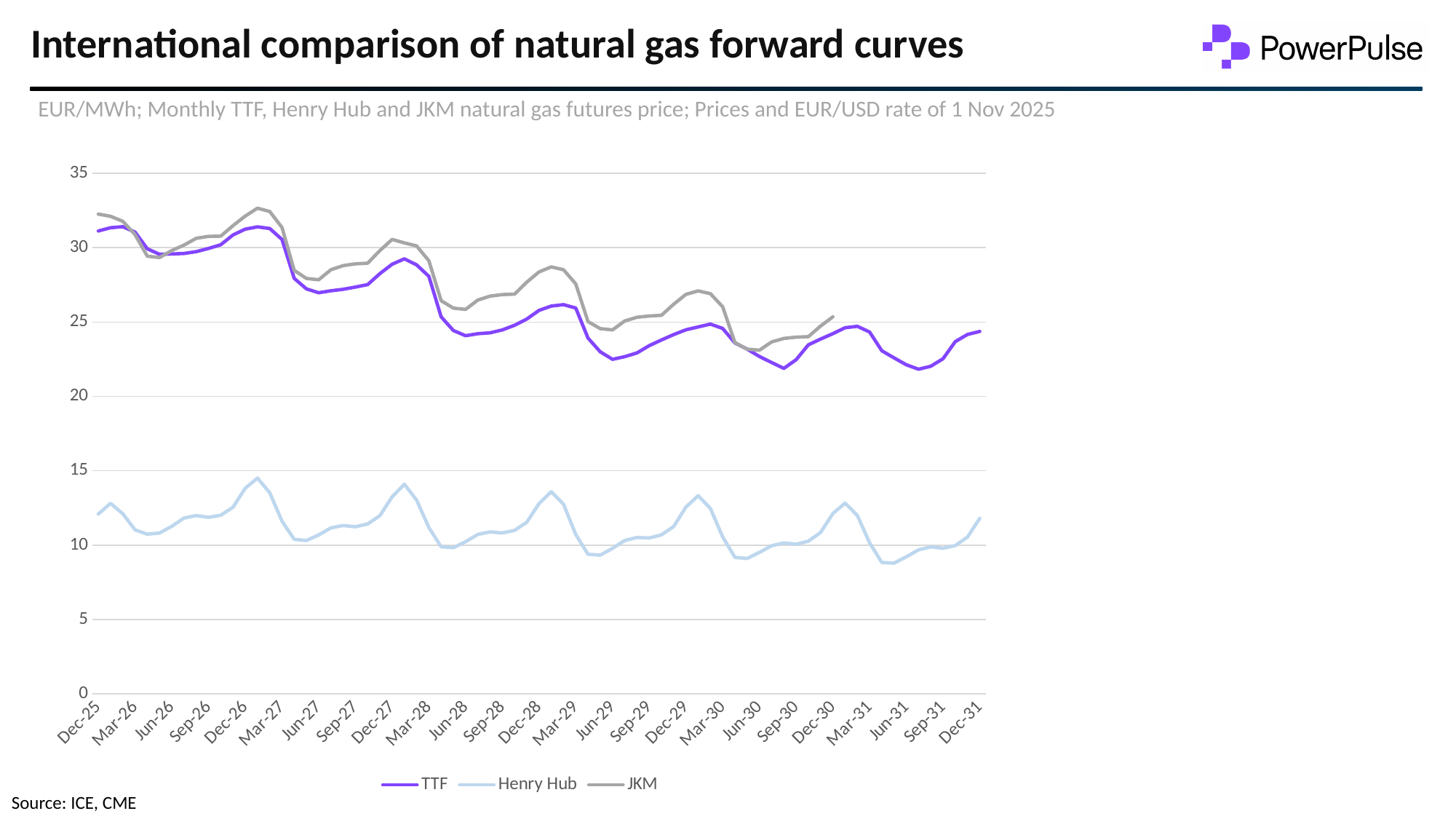
At Dec-25, which series has the higher value, TTF or Henry Hub? TTF Is the value for JKM at Dec-26 greater or less than 30? greater What source is cited for the chart? ICE, CME Is the value for TTF at Jun-31 greater or less than 25? less At Dec-28, which series has the higher value, JKM or TTF? JKM Is the value for Henry Hub at Dec-26 greater or less than 10? greater How many series does the legend list? 3 Does the TTF series rise or fall overall from Dec-25 to Dec-31? fall Which series are listed in the legend? TTF, Henry Hub, JKM What kind of chart is shown on the slide? line chart